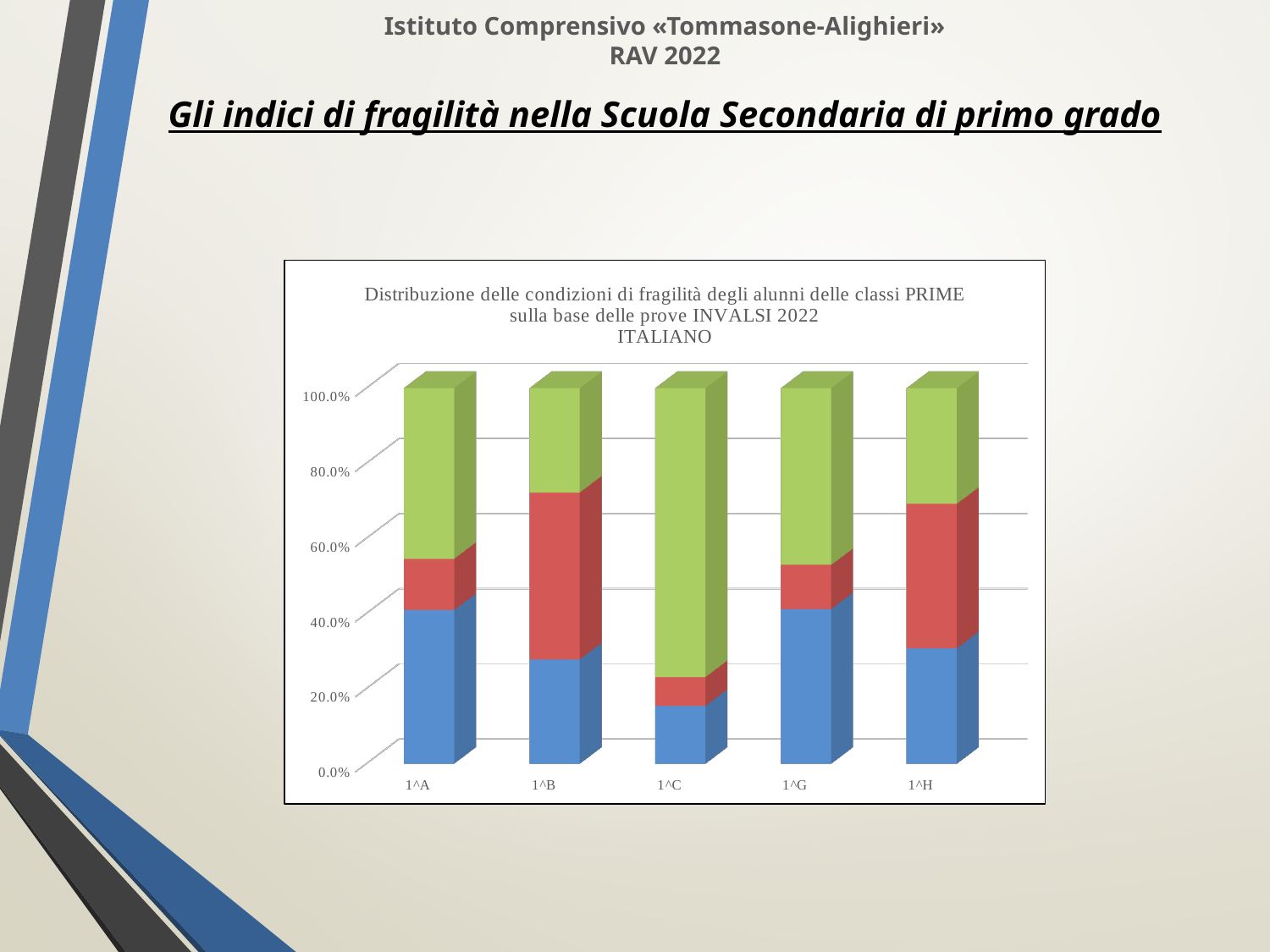
How many classes are shown on the x axis of the chart? 5 Which class has the largest green (top) segment? 1^C Which class has the smallest blue (bottom) segment? 1^C Is the blue segment for 1^B greater or less than 40.0%? less Is the blue segment for 1^C greater or less than 20.0%? less Which class has the smallest red (middle) segment? 1^C Which is larger, the blue segment for 1^G or the blue segment for 1^H? 1^G What is the total height of the stacked bar for 1^A? 100.0% What is the title of the chart? Distribuzione delle condizioni di fragilità degli alunni delle classi PRIME sulla base delle prove INVALSI 2022 ITALIANO How many coloured segments make up each stacked bar? 3 What kind of chart is shown on the slide? stacked bar chart